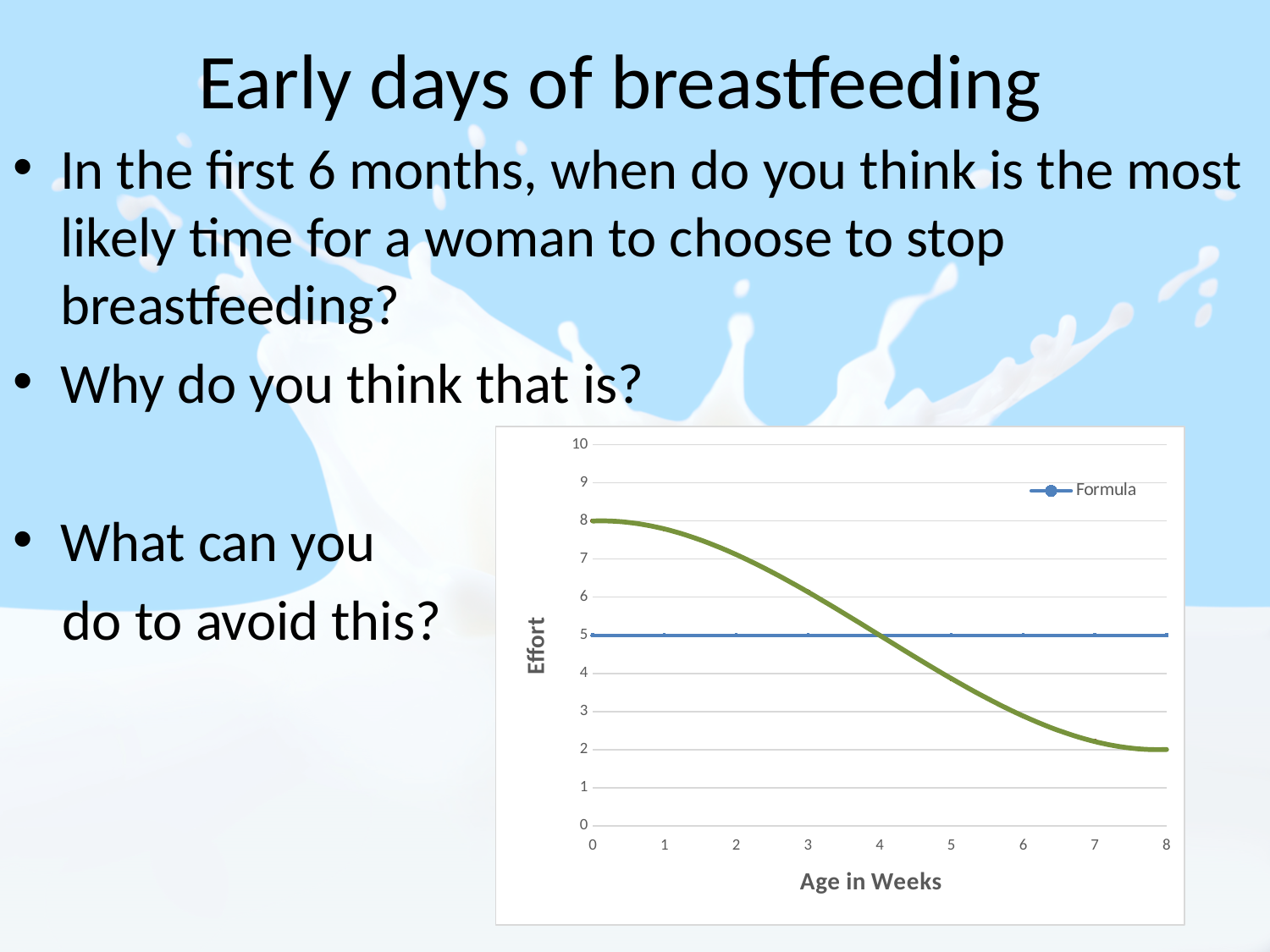
What is the Effort value of the Formula line at week 4? 5 What is the Effort value of the green line at week 8? 2 How many series does the chart's legend list? 1 Is the Formula value at week 2 greater or less than 6? less What kind of chart is shown on the slide? line chart At week 7, which is higher: the green line or the Formula line? the Formula line Does the Formula line rise, fall or stay flat as Age in Weeks increases? stays flat What is the Effort value of the green line at week 0? 8 What is the name of the series listed in the chart's legend? Formula At week 1, which is higher: the green line or the Formula line? the green line What is the title of the chart's x axis? Age in Weeks Does the green line rise or fall as Age in Weeks increases from 0 to 8? falls